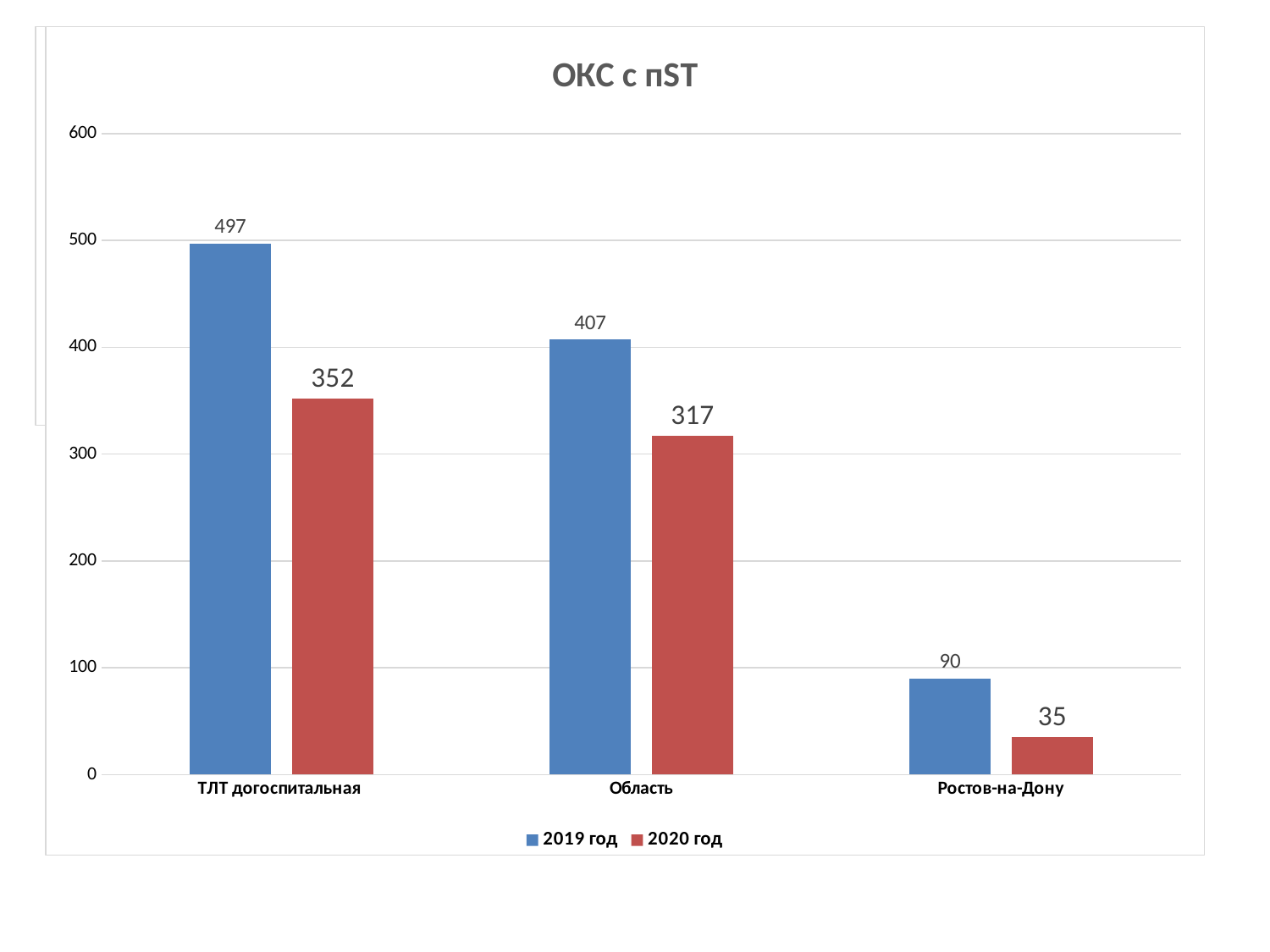
What is the value for ТЛТ догоспитальная in 2019 год? 497 How many categories are shown on the x axis? 3 How many series does the legend list? 2 Which is larger: the 2020 год value for ТЛТ догоспитальная or the 2019 год value for Область? 2019 год value for Область What is the value for Ростов-на-Дону in 2020 год? 35 What is the difference between the 2019 год and 2020 год values for ТЛТ догоспитальная? 145 What is the value for Область in 2020 год? 317 Which category has the lowest value in 2020 год? Ростов-на-Дону What is the difference between the 2019 год and 2020 год values for Ростов-на-Дону? 55 Which category has the highest value in 2019 год? ТЛТ догоспитальная What kind of chart is this? bar chart What is the title of the chart? ОКС с пST